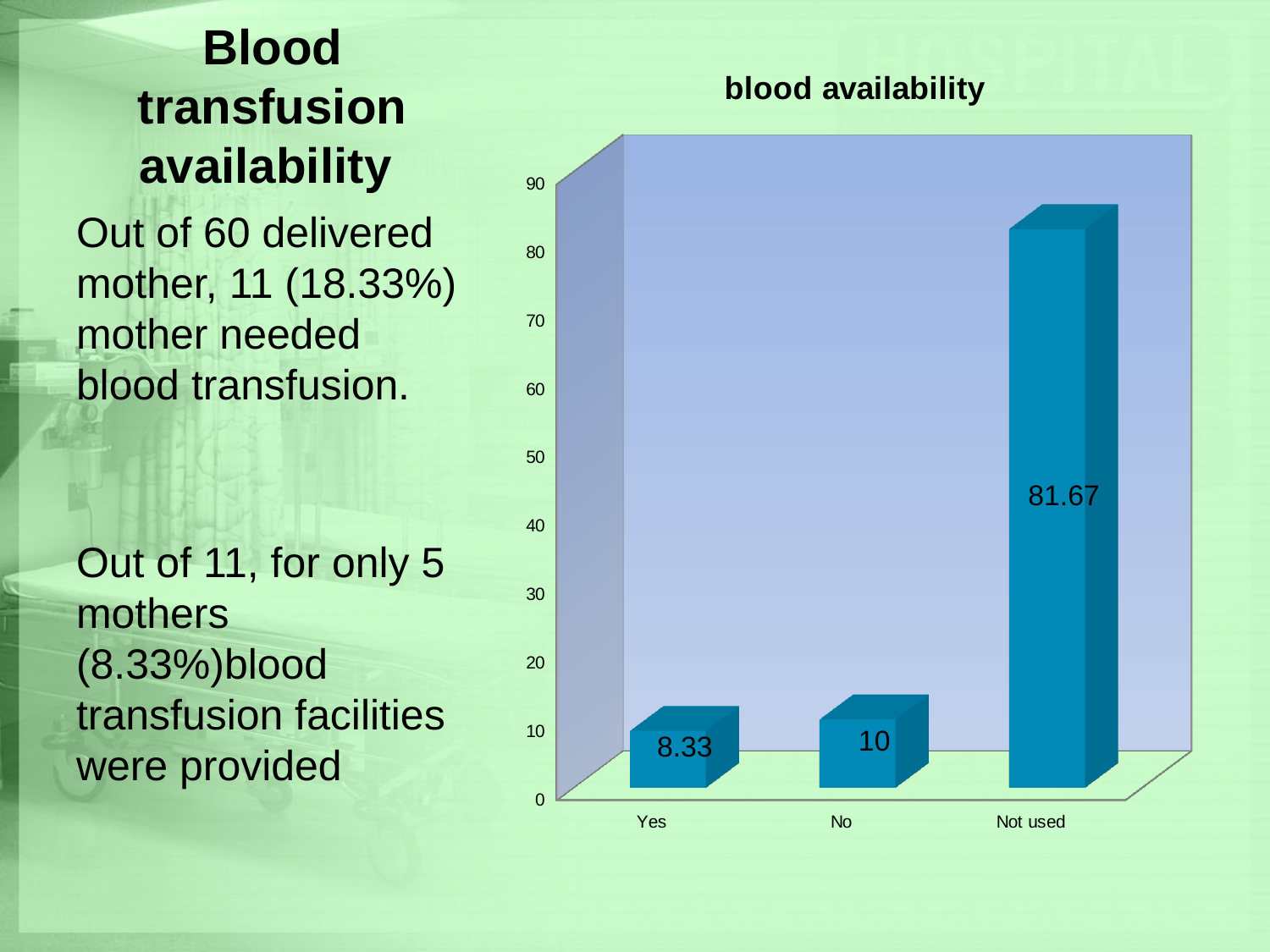
What is the title of the chart? blood availability Is the value for Not used greater or less than 80? greater How many categories are shown on the x axis? 3 Which is larger, the value for Yes or the value for No? No What is the value for Yes? 8.33 What kind of chart is shown? bar chart What is the value for Not used? 81.67 What is the difference between the values for Not used and No? 71.67 Which category has the lowest value? Yes What is the difference between the values for No and Yes? 1.67 What is the value for No? 10 Which category has the highest value? Not used